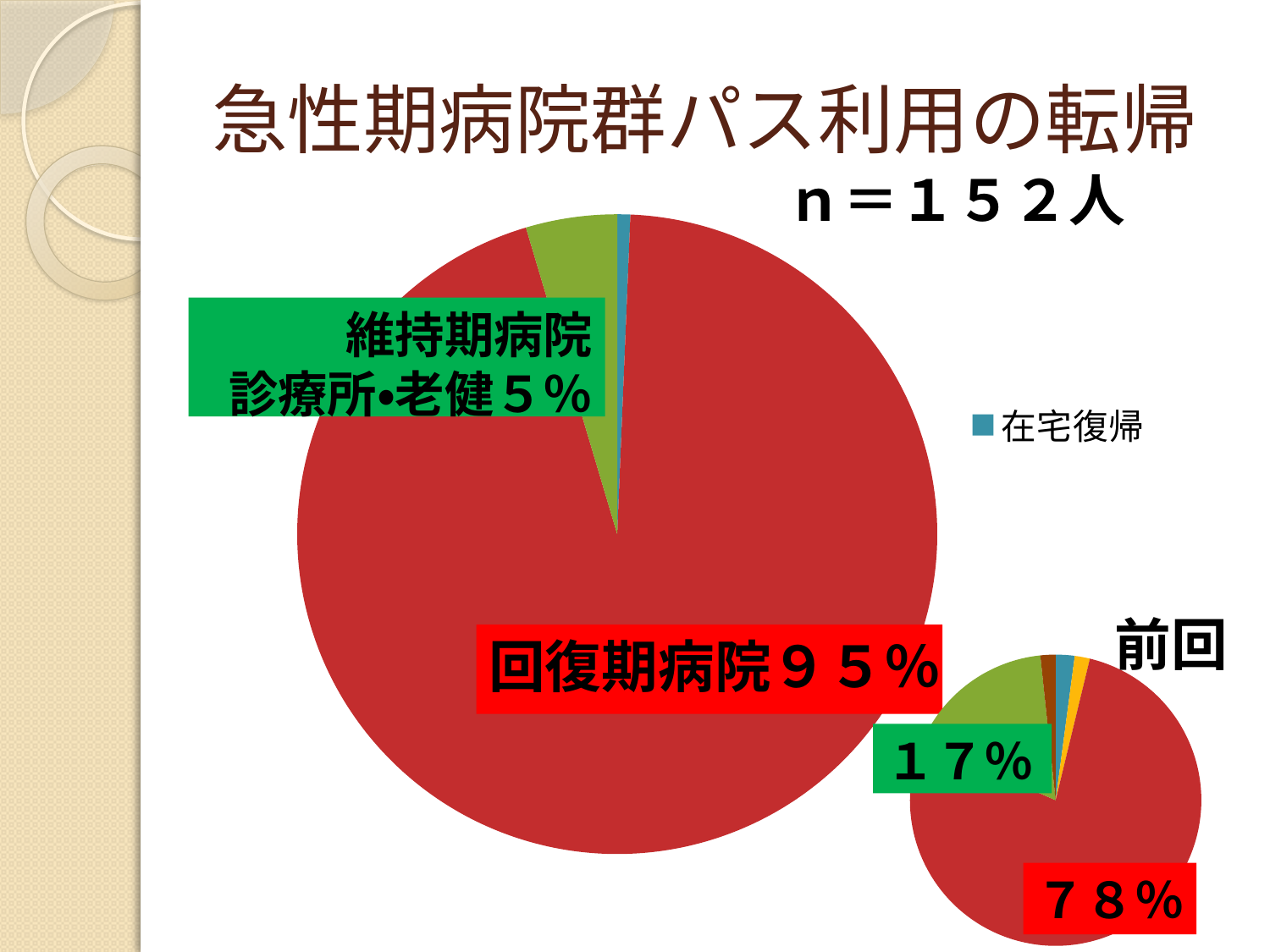
In the large pie chart, what share is labelled for 回復期病院? 95% How many slices does the large pie chart have? 3 In the large pie chart, which category has the largest slice? 回復期病院 In the small 前回 pie chart, what share is labelled on the green slice? 17% How many percentage points larger is the green slice in the 前回 pie chart (17%) than the green slice in the large pie chart (5%)? 12 percentage points What kind of chart is the large chart on the slide? pie chart What legend entry is shown next to the large pie chart? 在宅復帰 What is the title of the slide containing the pie charts? 急性期病院群パス利用の転帰 Is the red slice larger in the large pie chart or in the small 前回 pie chart? the large pie chart In the small 前回 pie chart, what share is labelled on the red slice? 78% How many percentage points higher is the 回復期病院 share in the large pie chart (95%) than the red slice in the 前回 pie chart (78%)? 17 percentage points In the large pie chart, what share is labelled for 維持期病院・診療所・老健? 5%